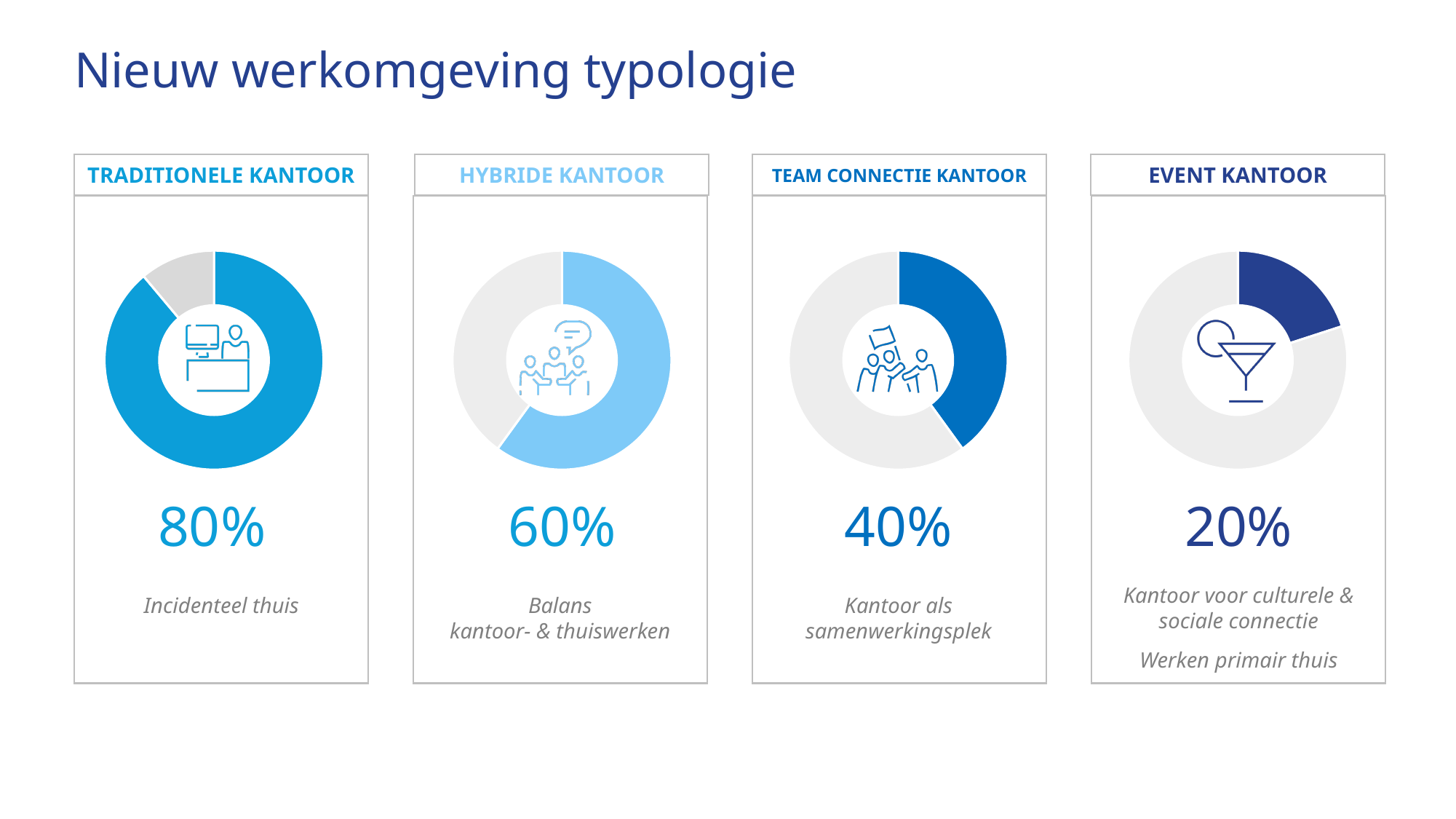
What percentage is shown in the Team Connectie Kantoor donut chart? 40% What percentage is shown in the Traditionele Kantoor donut chart? 80% Which of the four office types has the lowest percentage? Event Kantoor What kind of chart is used in each of the four panels? Donut chart Which of the four office types has the highest percentage? Traditionele Kantoor What percentage is shown in the Event Kantoor donut chart? 20% What percentage is shown in the Hybride Kantoor donut chart? 60% Do the percentages rise or fall moving from the leftmost chart to the rightmost chart? Fall What is the difference between the Traditionele Kantoor percentage and the Event Kantoor percentage? 60% Which has a larger percentage, Hybride Kantoor or Team Connectie Kantoor? Hybride Kantoor How many donut charts are shown on the slide? 4 What is the difference between the Hybride Kantoor percentage and the Team Connectie Kantoor percentage? 20%